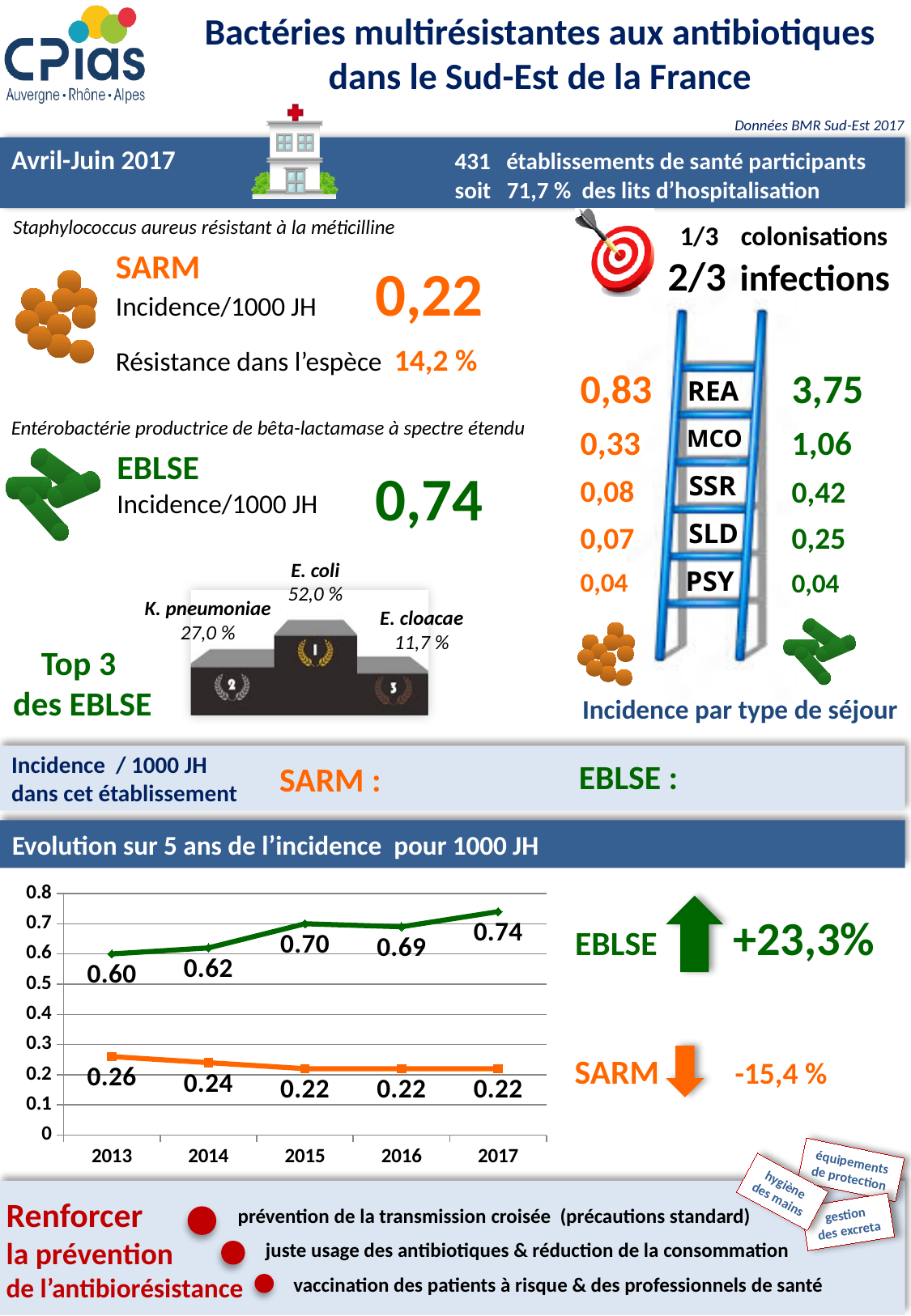
In the line chart, in which year is the EBLSE value highest? 2017 In the line chart, which is larger in 2016: the EBLSE value or the SARM value? EBLSE In the line chart, what is the EBLSE value for 2017? 0.74 In the line chart, what is the SARM value for 2013? 0.26 In the line chart, what is the SARM value for 2014? 0.24 In the line chart, in which year is the SARM value highest? 2013 How many years are shown on the x axis of the line chart? 5 In the line chart, what is the difference between the EBLSE value in 2017 and in 2013? 0.14 What type of chart is shown under 'Evolution sur 5 ans de l'incidence pour 1000 JH'? line chart In the line chart, in which year is the EBLSE value lowest? 2013 In the line chart, what is the EBLSE value for 2015? 0.70 In the line chart, does the SARM line rise or fall from 2013 to 2017? fall